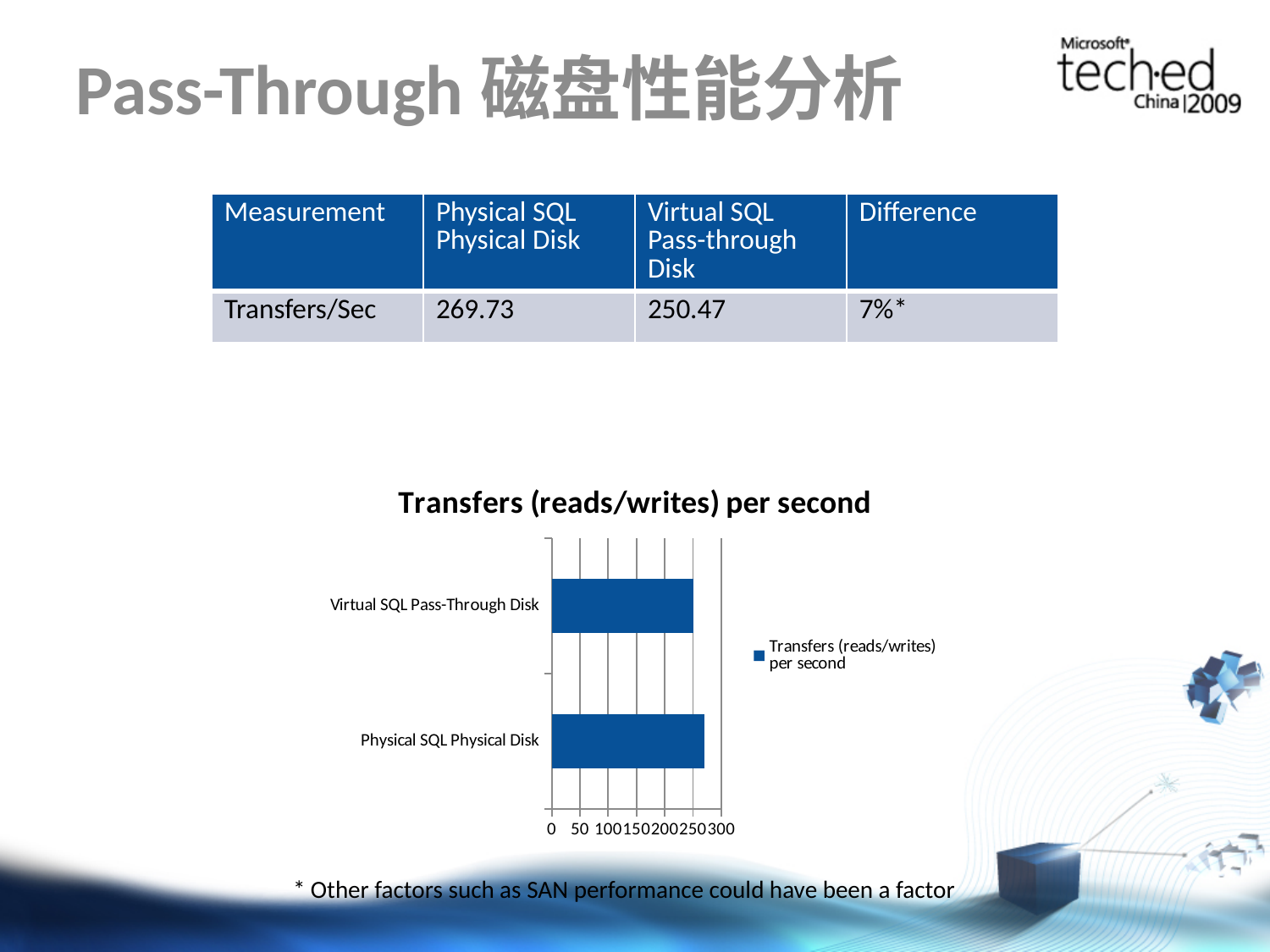
How many series does the chart legend list? 1 Is the value for Virtual SQL Pass-Through Disk greater or less than 200? greater According to the slide, what is the Transfers/Sec value for Physical SQL Physical Disk? 269.73 Which category has the higher transfers per second in the chart? Physical SQL Physical Disk What kind of chart is shown on the slide? bar chart How many categories does the chart show? 2 Which category has the lower transfers per second in the chart? Virtual SQL Pass-Through Disk According to the slide, what is the Transfers/Sec value for Virtual SQL Pass-through Disk? 250.47 Which is larger: the bar for Physical SQL Physical Disk or the bar for Virtual SQL Pass-Through Disk? Physical SQL Physical Disk Is the value for Physical SQL Physical Disk greater or less than 300? less What is the title of the chart? Transfers (reads/writes) per second Is the value for Virtual SQL Pass-Through Disk greater or less than 300? less